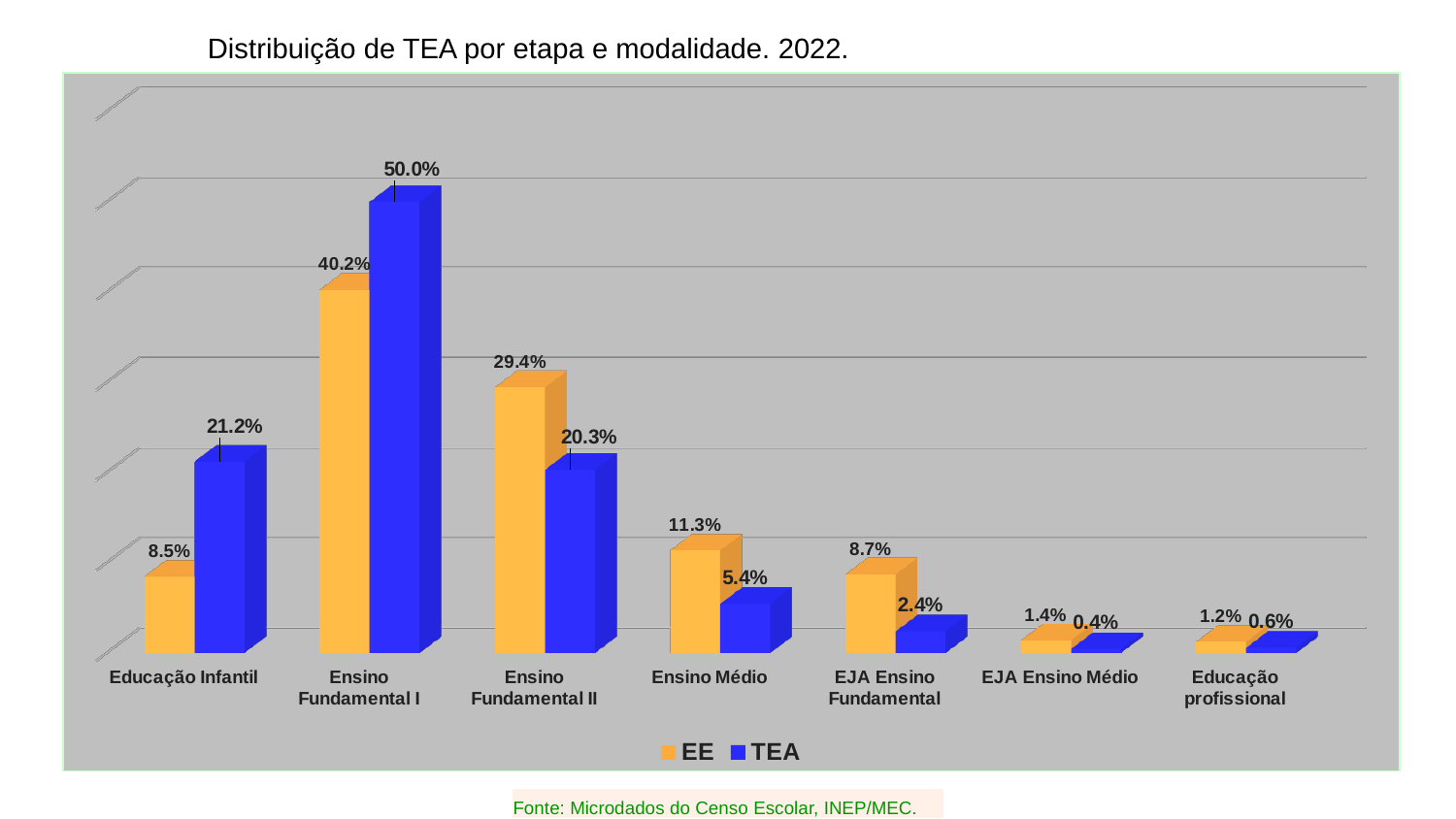
What is the TEA value for Educação Infantil? 21.2% What is the TEA value for Ensino Fundamental I? 50.0% What is the difference between the TEA and EE values for Ensino Fundamental I? 9.8% Which category has the highest TEA value? Ensino Fundamental I How many categories are shown on the x axis? 7 What is the EE value for EJA Ensino Fundamental? 8.7% How many series does the legend list? 2 Which category has the lowest TEA value? EJA Ensino Médio What kind of chart is shown on the slide? Bar chart What is the title of the chart? Distribuição de TEA por etapa e modalidade. 2022. Which is larger for Ensino Médio, the EE value or the TEA value? EE What is the EE value for Ensino Fundamental II? 29.4%